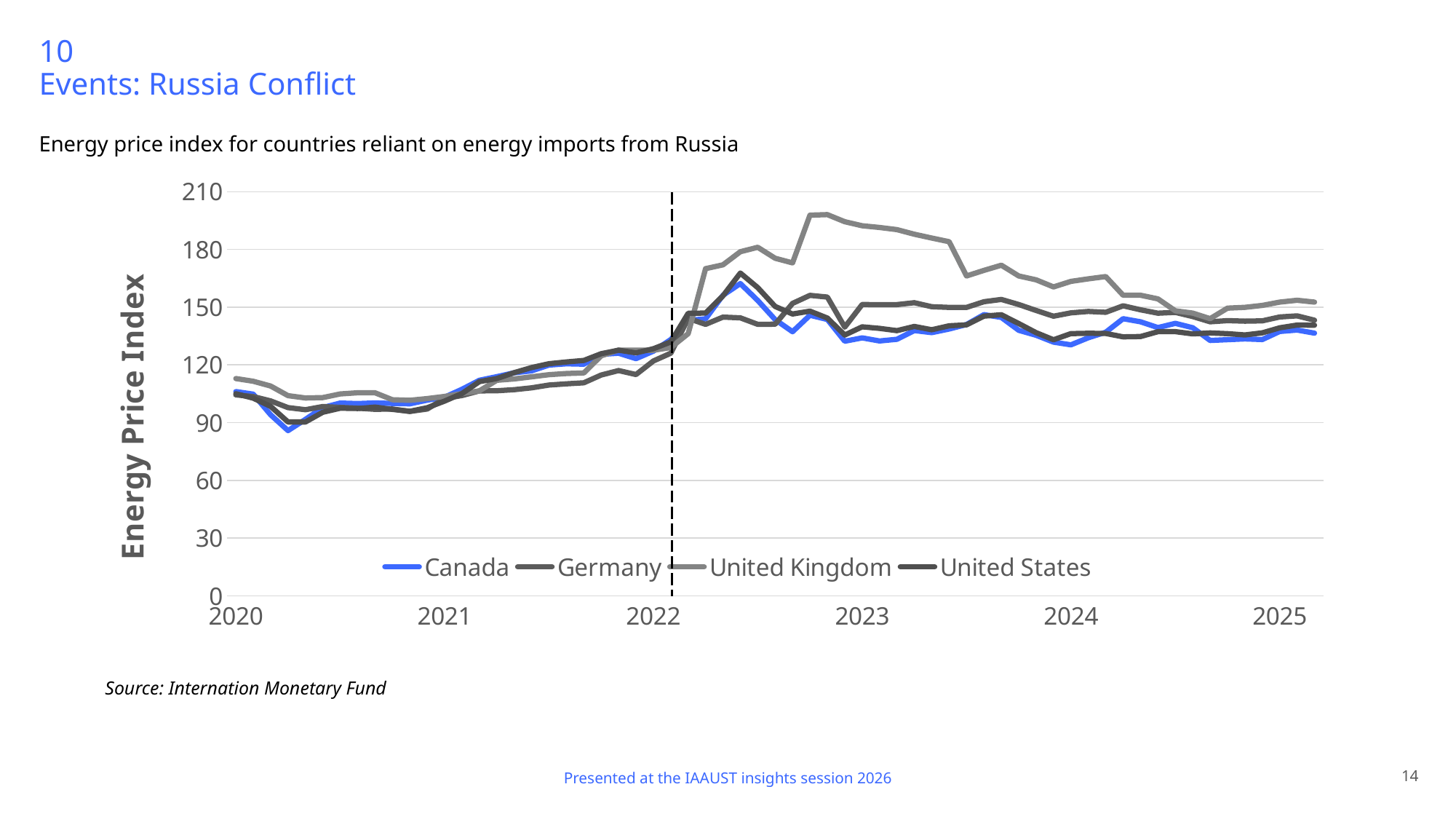
Which series reaches the highest value anywhere on the chart? United Kingdom Is the peak value for the United Kingdom in late 2022 greater or less than 180? greater Do the values for the four countries generally rise or fall between 2020 and the start of 2022? rise What is the title of the vertical axis? Energy Price Index Is the value for Canada at the start of 2020 greater or less than 120? less How many year labels are shown on the x axis? 6 At the start of 2023, which is larger, the value for the United Kingdom or the value for Canada? United Kingdom Is the value for Germany at the start of 2025 greater or less than 120? greater Does the United Kingdom line rise or fall from its late-2022 peak to 2025? fall What kind of chart is shown on the slide? line chart Which countries are listed in the chart legend? Canada, Germany, United Kingdom, United States How many series does the legend list? 4